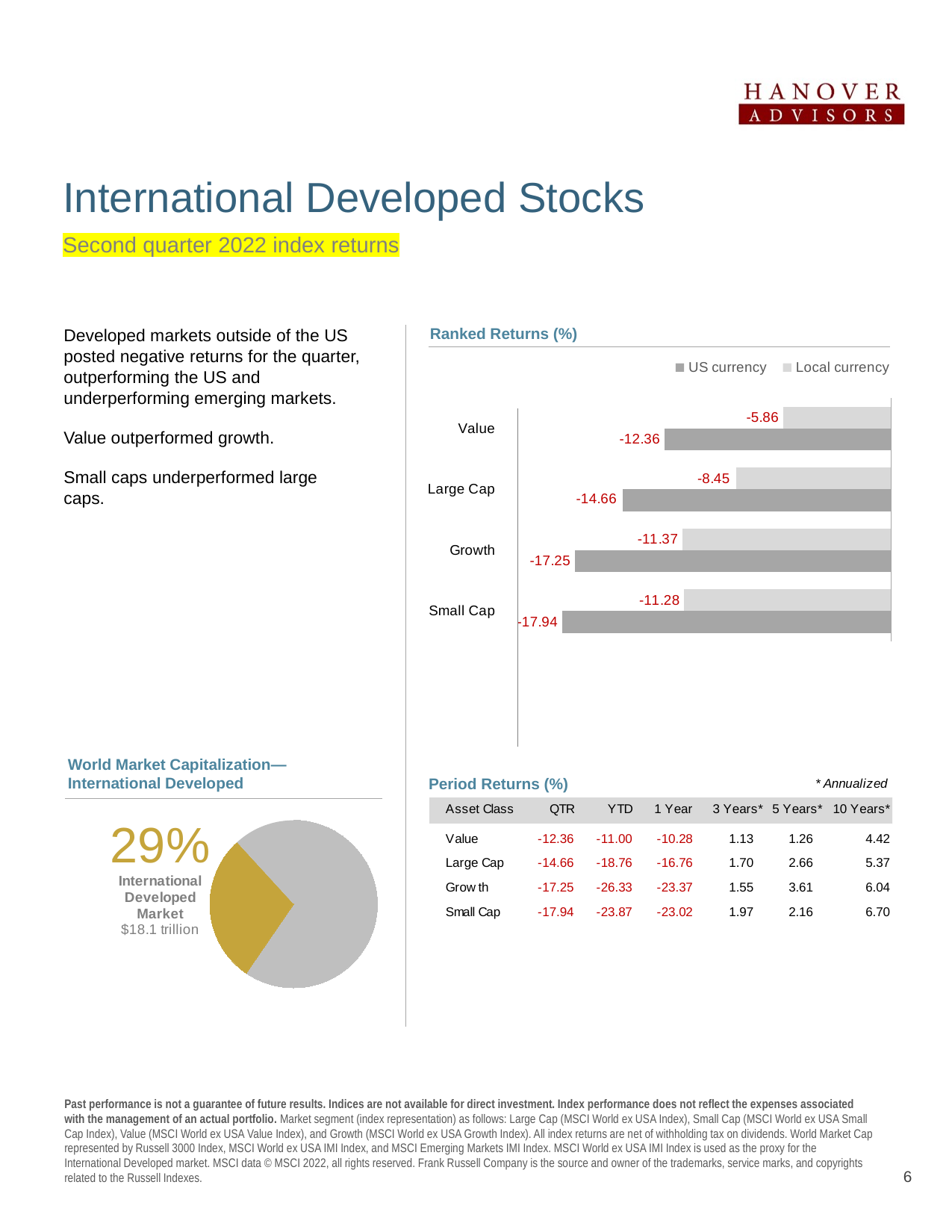
How many series does the legend of the Ranked Returns (%) chart list? 2 In the Ranked Returns (%) chart, what is the Local currency return for Growth? -11.37 In the World Market Capitalization—International Developed chart, what share does the International Developed Market represent? 29% How many categories are shown in the Ranked Returns (%) chart? 4 What are the two legend entries in the Ranked Returns (%) chart? US currency and Local currency What kind of chart is the Ranked Returns (%) chart? Bar chart In the Ranked Returns (%) chart, what is the difference between the Local currency and US currency returns for Value? 6.50 In the Ranked Returns (%) chart, which category has the highest US currency return? Value In the Ranked Returns (%) chart, which category has the lowest US currency return? Small Cap What kind of chart is the World Market Capitalization—International Developed chart? Pie chart In the Ranked Returns (%) chart, which is larger: the Local currency return for Growth or for Small Cap? Small Cap In the Ranked Returns (%) chart, what is the US currency return for Large Cap? -14.66